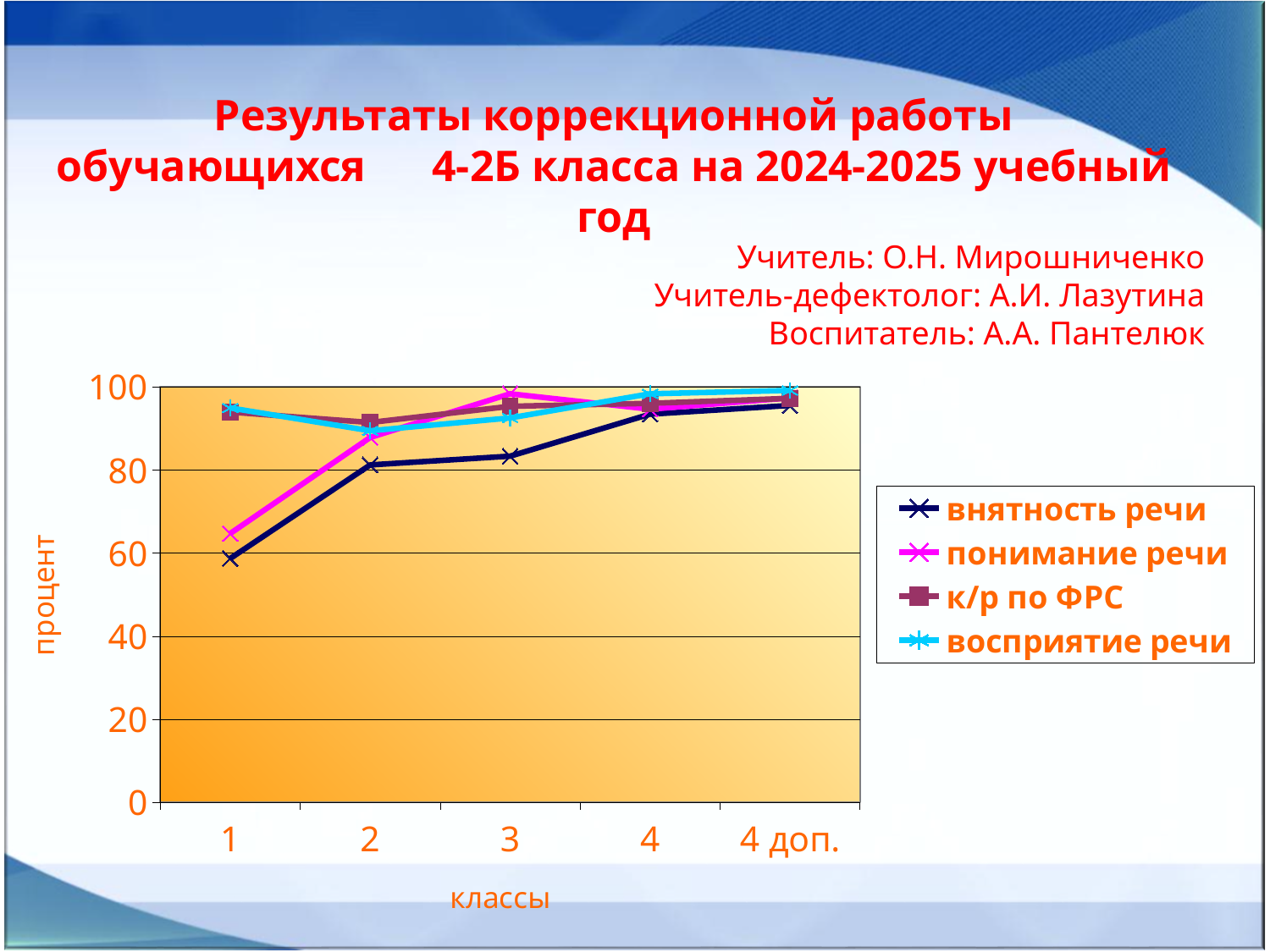
Does the value for внятность речи rise or fall from class 1 to class 4 доп.? rise At class 2, which is larger: к/р по ФРС or внятность речи? к/р по ФРС What kind of chart is shown on the slide? line chart How many series does the legend list? 4 Is the value for внятность речи at class 3 greater or less than 60? greater Is the value for внятность речи at class 1 greater or less than 80? less Is the value for к/р по ФРС at class 1 greater or less than 80? greater How many categories are shown on the x axis? 5 At class 1, which is larger: понимание речи or внятность речи? понимание речи Which series has the lowest value at class 1? внятность речи What is the title of the vertical axis? процент